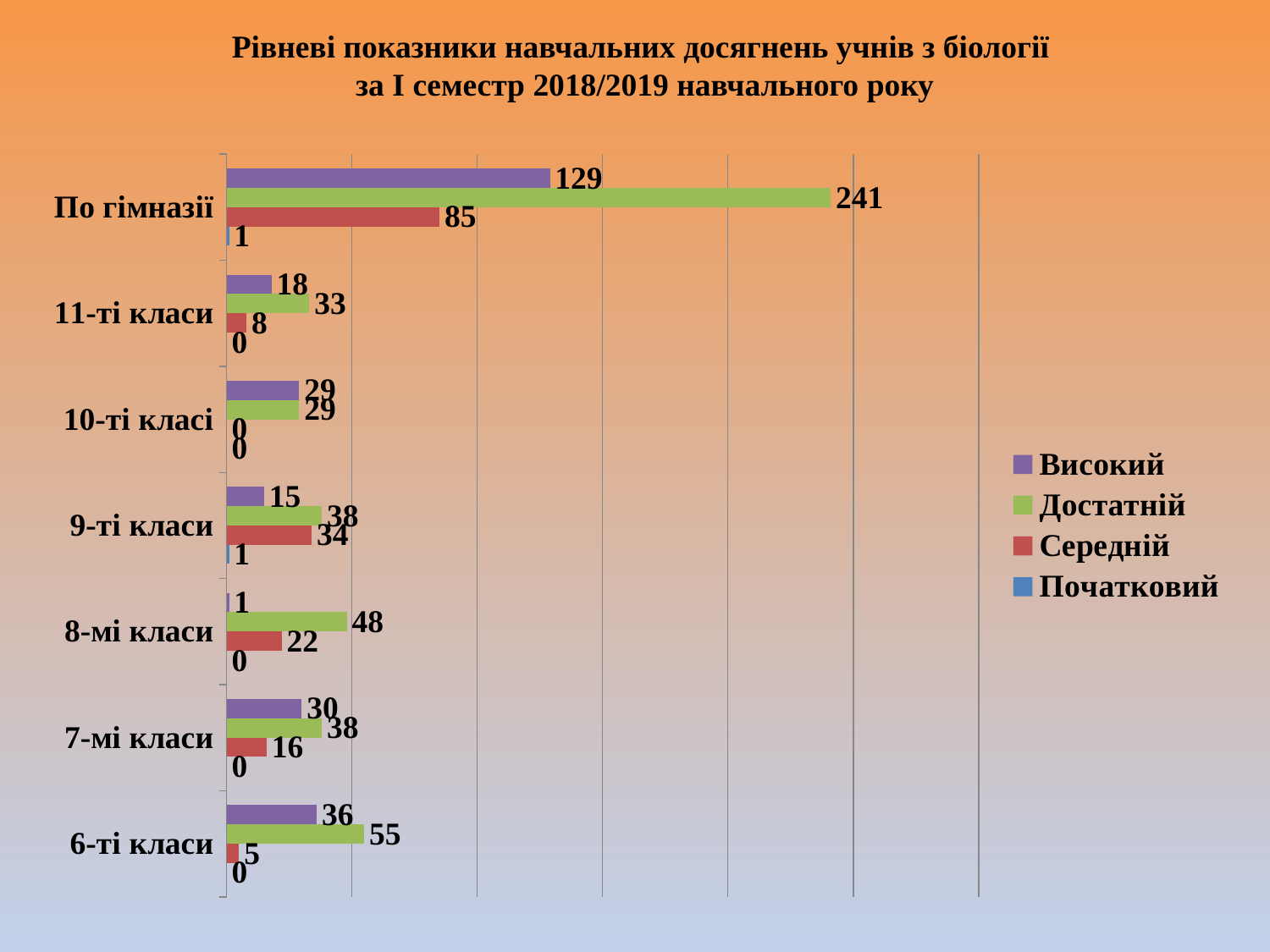
Among the class categories (excluding По гімназії), which has the lowest Високий value? 8-мі класи What type of chart is shown on the slide? bar chart What is the value of Високий for 8-мі класи? 1 What is the difference between the Достатній values for 6-ті класи and 11-ті класи? 22 What is the difference between the Достатній and Високий values for По гімназії? 112 How many categories are shown on the vertical axis? 7 What is the value of Середній for 9-ті класи? 34 Which category has the highest Достатній value? По гімназії How many series does the legend list? 4 Which series is shown in green in the legend? Достатній Which is larger for 7-мі класи: Високий or Середній? Високий What is the value of Достатній for По гімназії? 241